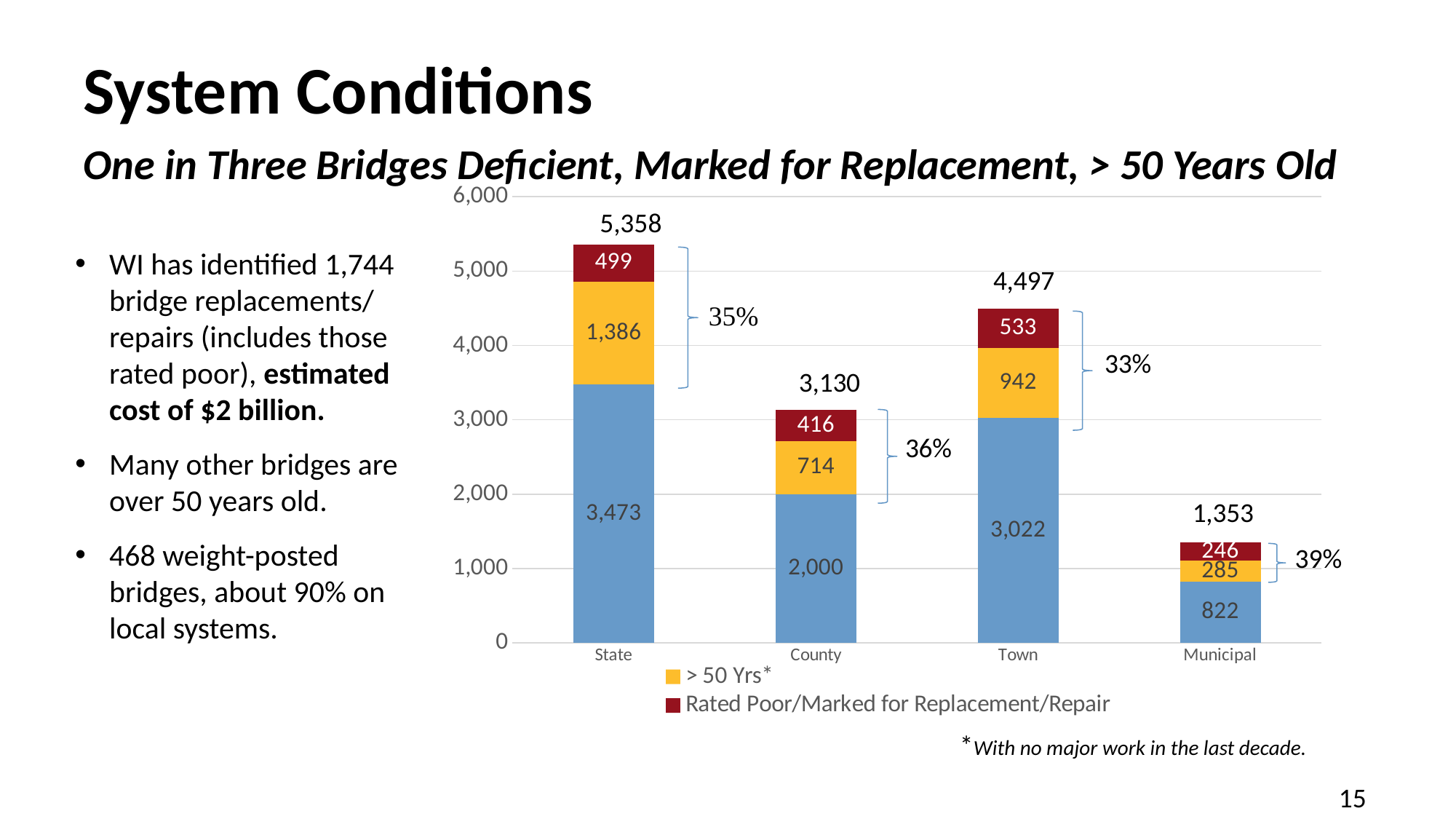
How many categories are shown on the x axis? 4 What is the difference between the totals for State and Town? 861 What is the value of the Rated Poor/Marked for Replacement/Repair segment for Town? 533 What kind of chart is shown on the slide? Stacked bar chart Which is larger, the > 50 Yrs segment for State or for Town? State What is the value of the bottom (blue) segment for Municipal? 822 What is the value of the > 50 Yrs segment for County? 714 What percentage is shown next to the bracket for the Municipal bar? 39% Which category has the lowest total? Municipal How many series does the legend list? 2 Which category has the highest total? State What is the total number of bridges shown for the State bar? 5,358